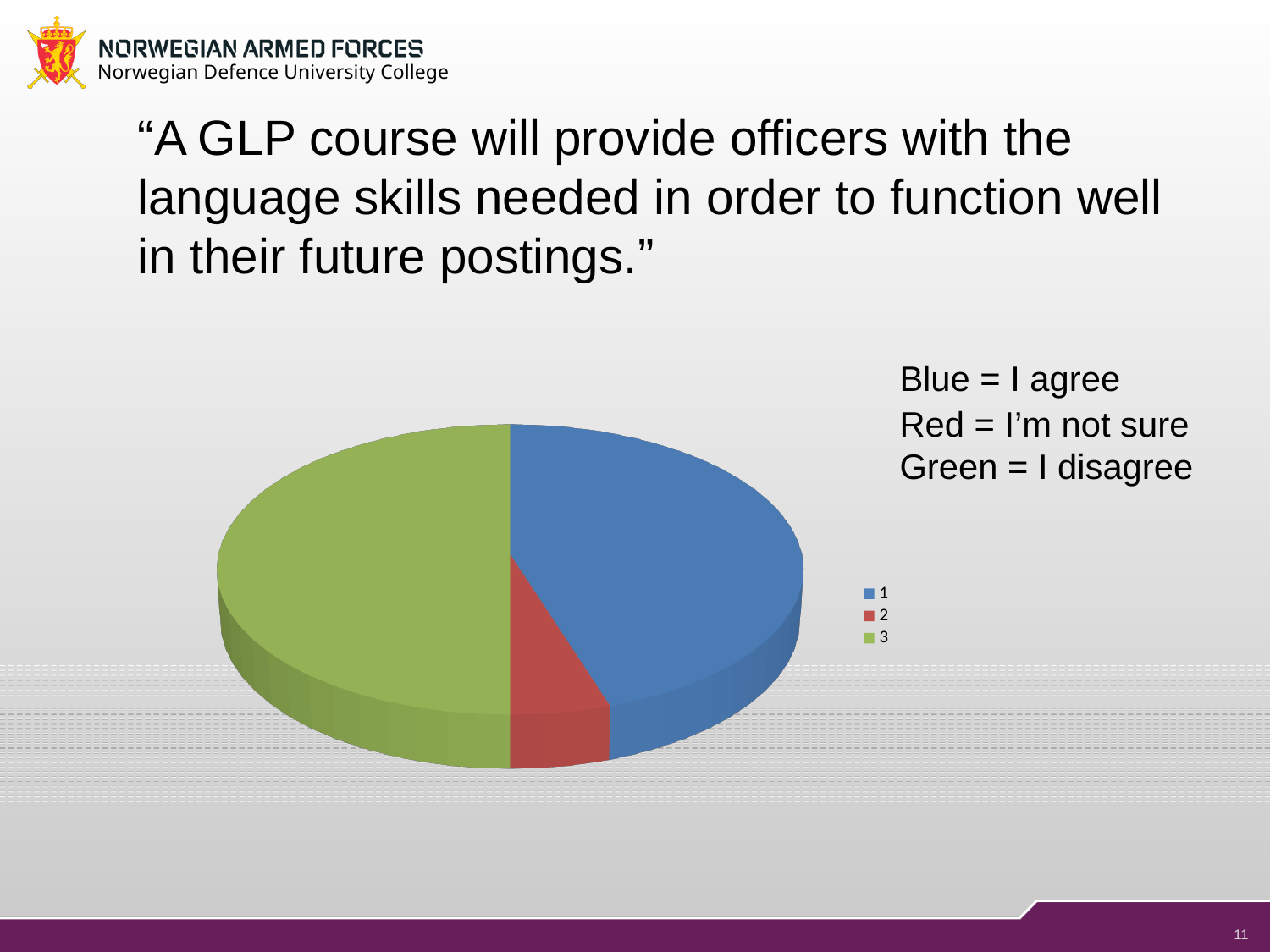
Which slice is larger, the blue slice (1) or the red slice (2)? blue (1) According to the slide, what response does the green slice represent? I disagree What are the entries listed in the chart legend? 1, 2, 3 Which slice is larger, the green slice (3) or the red slice (2)? green (3) Which slice of the pie chart is the smallest? 2 (red, I'm not sure) What kind of chart is shown on the slide? pie chart Which slice of the pie chart is the largest? 3 (green, I disagree) How many entries does the chart legend list? 3 How many slices does the pie chart have? 3